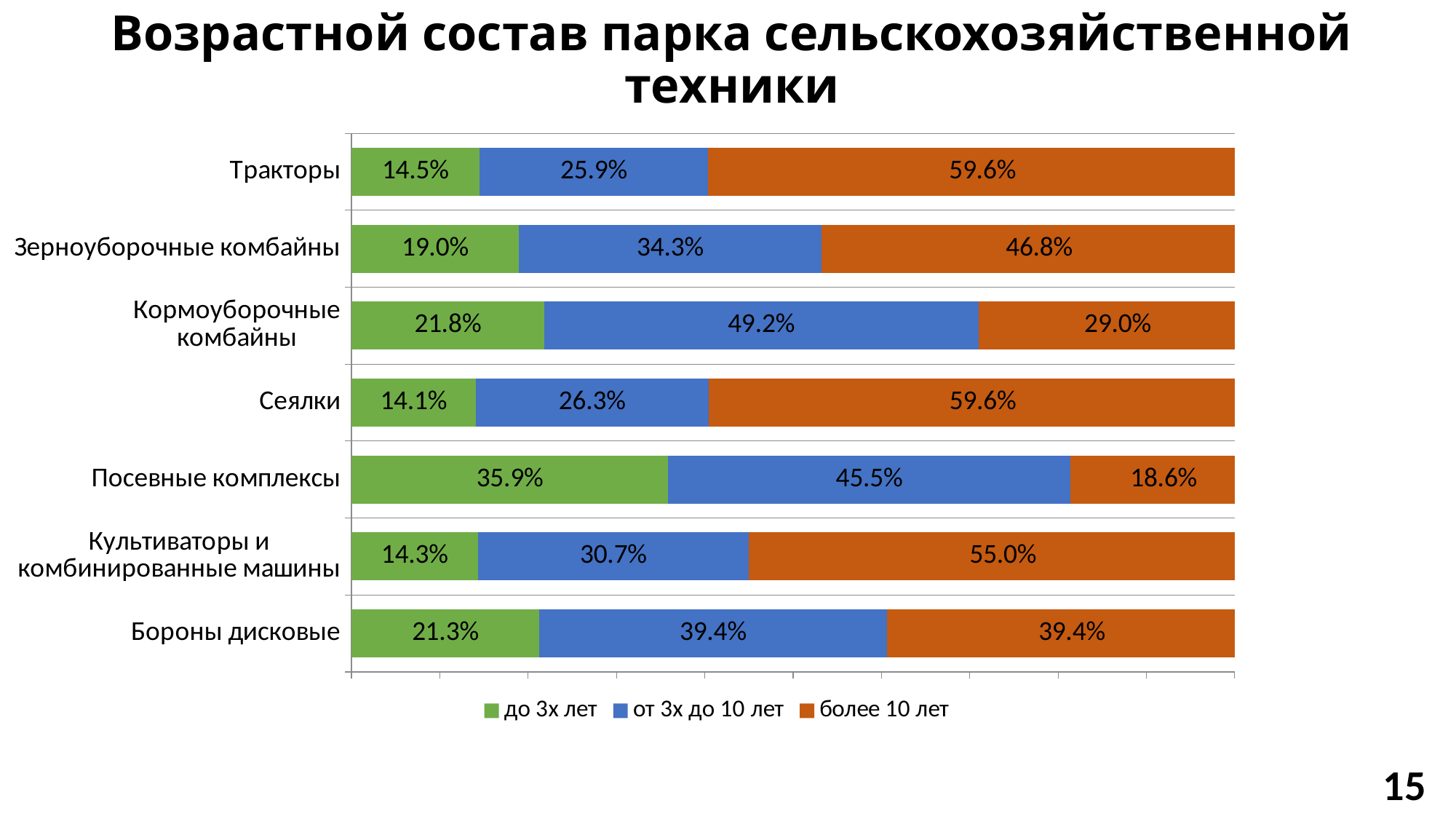
What is the difference between the 'более 10 лет' and 'до 3х лет' values for Тракторы? 45.1 percentage points Which category has the highest share of 'до 3х лет'? Посевные комплексы How many series does the legend list? 3 Which has a larger 'от 3х до 10 лет' value: Зерноуборочные комбайны or Культиваторы и комбинированные машины? Зерноуборочные комбайны How many equipment categories are shown on the chart? 7 What is the value of 'более 10 лет' for Тракторы? 59.6% Which category has the highest share of 'от 3х до 10 лет'? Кормоуборочные комбайны What is the title of the chart on the slide? Возрастной состав парка сельскохозяйственной техники What type of chart is shown on the slide? Stacked bar chart Which category has the lowest share of 'более 10 лет'? Посевные комплексы What is the value of 'до 3х лет' for Бороны дисковые? 21.3% What is the value of 'от 3х до 10 лет' for Кормоуборочные комбайны? 49.2%